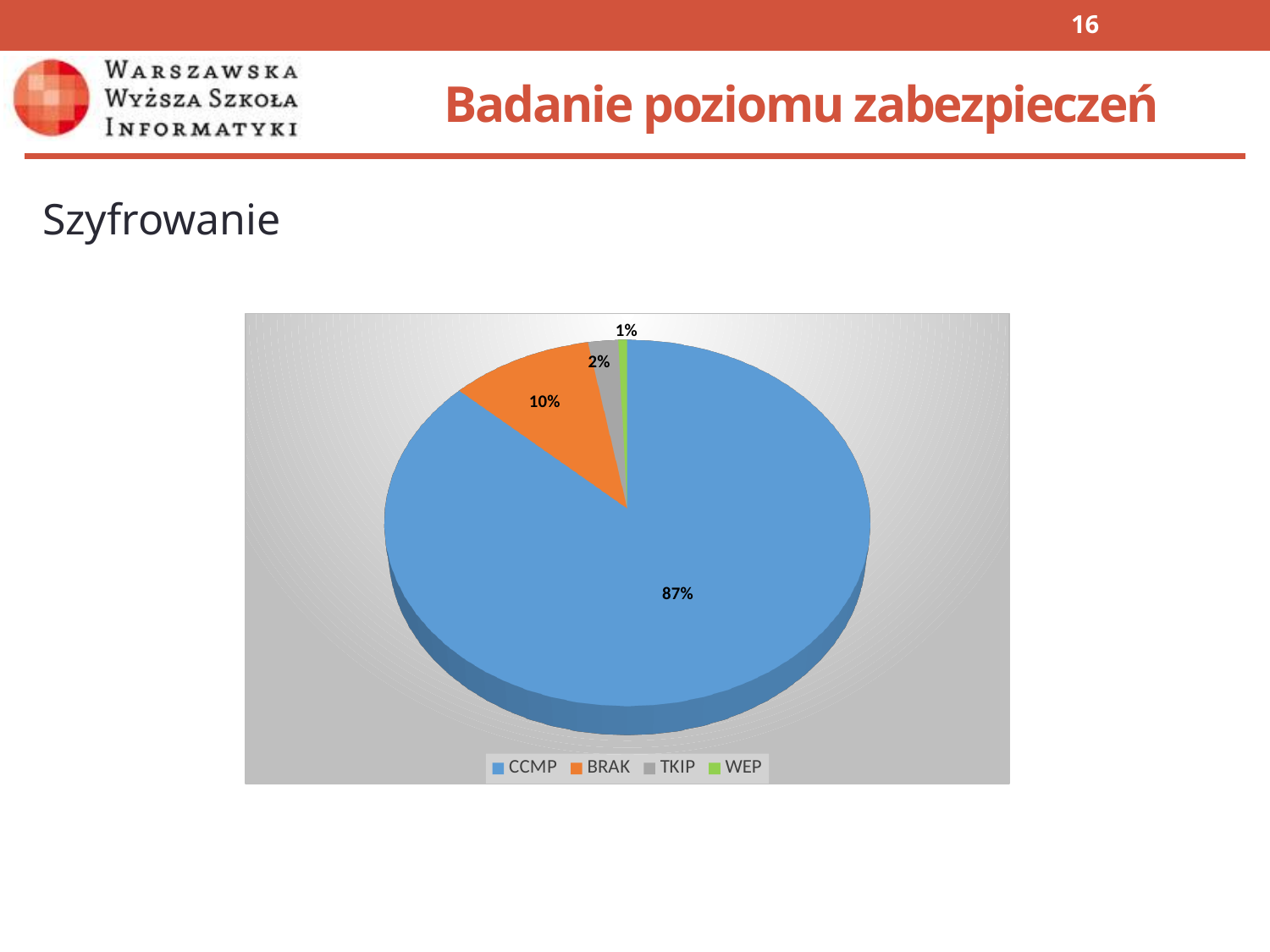
What is the difference in percentage points between BRAK and TKIP? 8 What share of the pie does WEP have? 1% What share of the pie does CCMP have? 87% What kind of chart is shown on the slide? pie chart What colour is the CCMP slice? blue What is the difference in percentage points between CCMP and BRAK? 77 Which is larger, the share for BRAK or the share for TKIP? BRAK What share of the pie does TKIP have? 2% How many categories does the legend list? 4 Which category has the largest slice of the pie? CCMP Which category has the smallest slice of the pie? WEP